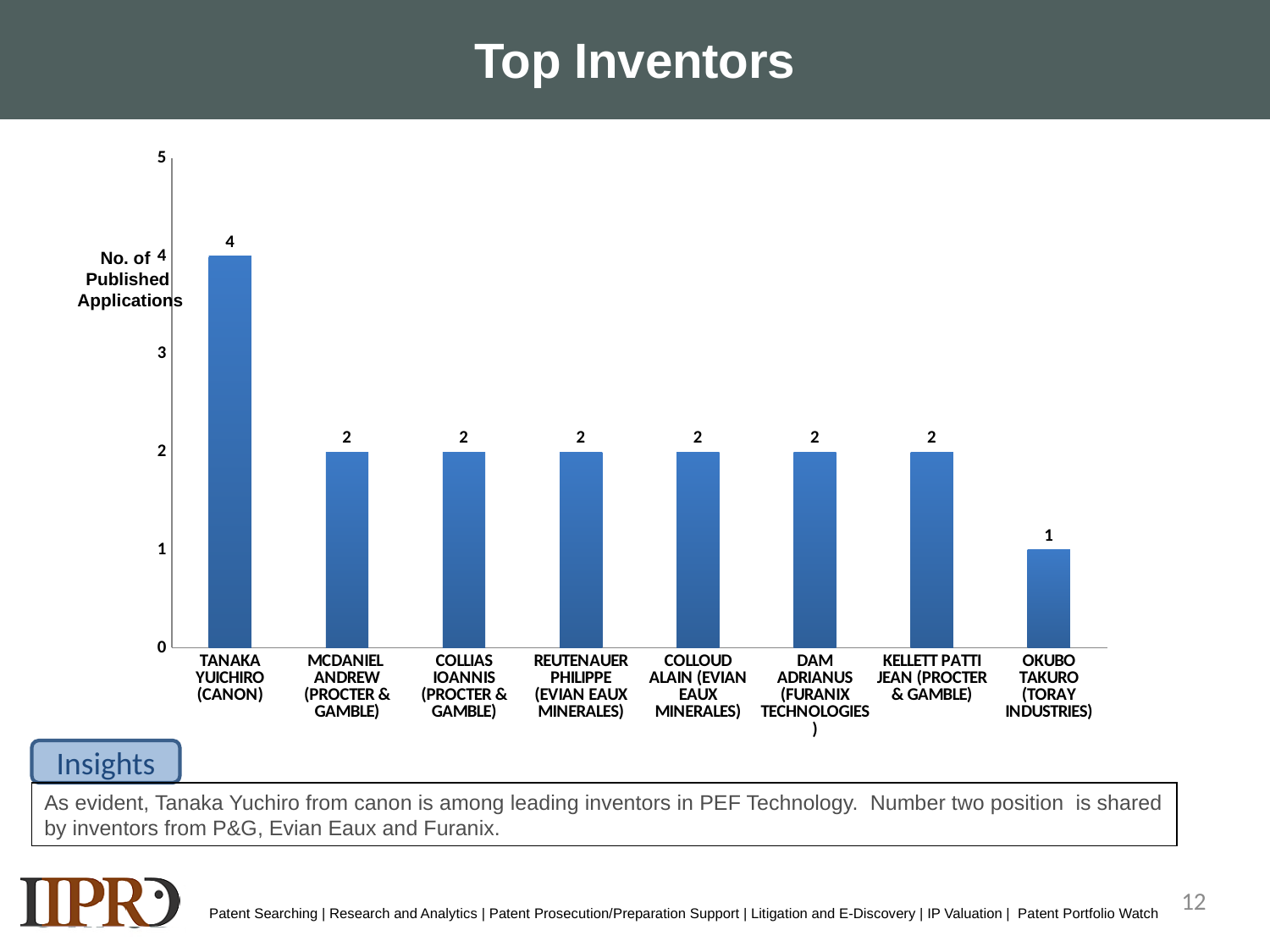
What is the difference in published applications between Tanaka Yuichiro (Canon) and Collias Ioannis (Procter & Gamble)? 2 What is the title of the chart on the slide? Top Inventors What is the number of published applications for Okubo Takuro (Toray Industries)? 1 How many published applications does Tanaka Yuichiro (Canon) have? 4 How many inventors have exactly 2 published applications? 6 Who has more published applications, Dam Adrianus (Furanix Technologies) or Okubo Takuro (Toray Industries)? Dam Adrianus (Furanix Technologies) Is the value for Tanaka Yuichiro (Canon) greater or less than 3? greater Which inventor has the highest number of published applications? Tanaka Yuichiro (Canon) How many inventors are shown in the chart? 8 How many published applications does McDaniel Andrew (Procter & Gamble) have? 2 Which inventor has the lowest number of published applications? Okubo Takuro (Toray Industries) What type of chart is shown on the slide? Bar chart